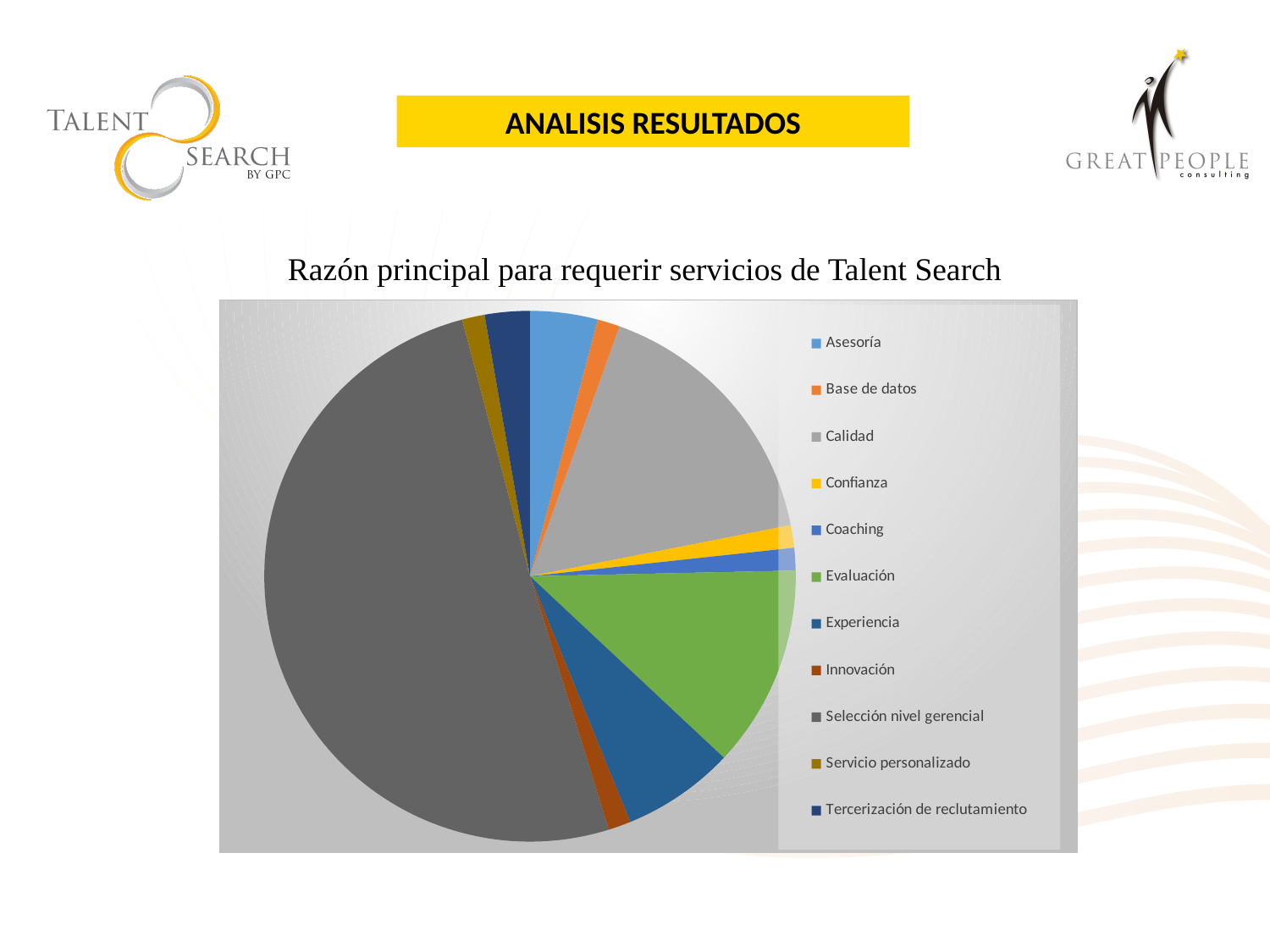
Which slice is larger, Selección nivel gerencial or Evaluación? Selección nivel gerencial What is the title of the chart? Razón principal para requerir servicios de Talent Search Which slice is larger, Asesoría or Base de datos? Asesoría Which category has the largest slice of the pie? Selección nivel gerencial Which slice is larger, Evaluación or Experiencia? Evaluación Which category is shown in green in the pie chart? Evaluación How many categories does the pie chart's legend list? 11 What kind of chart is shown on the slide? pie chart